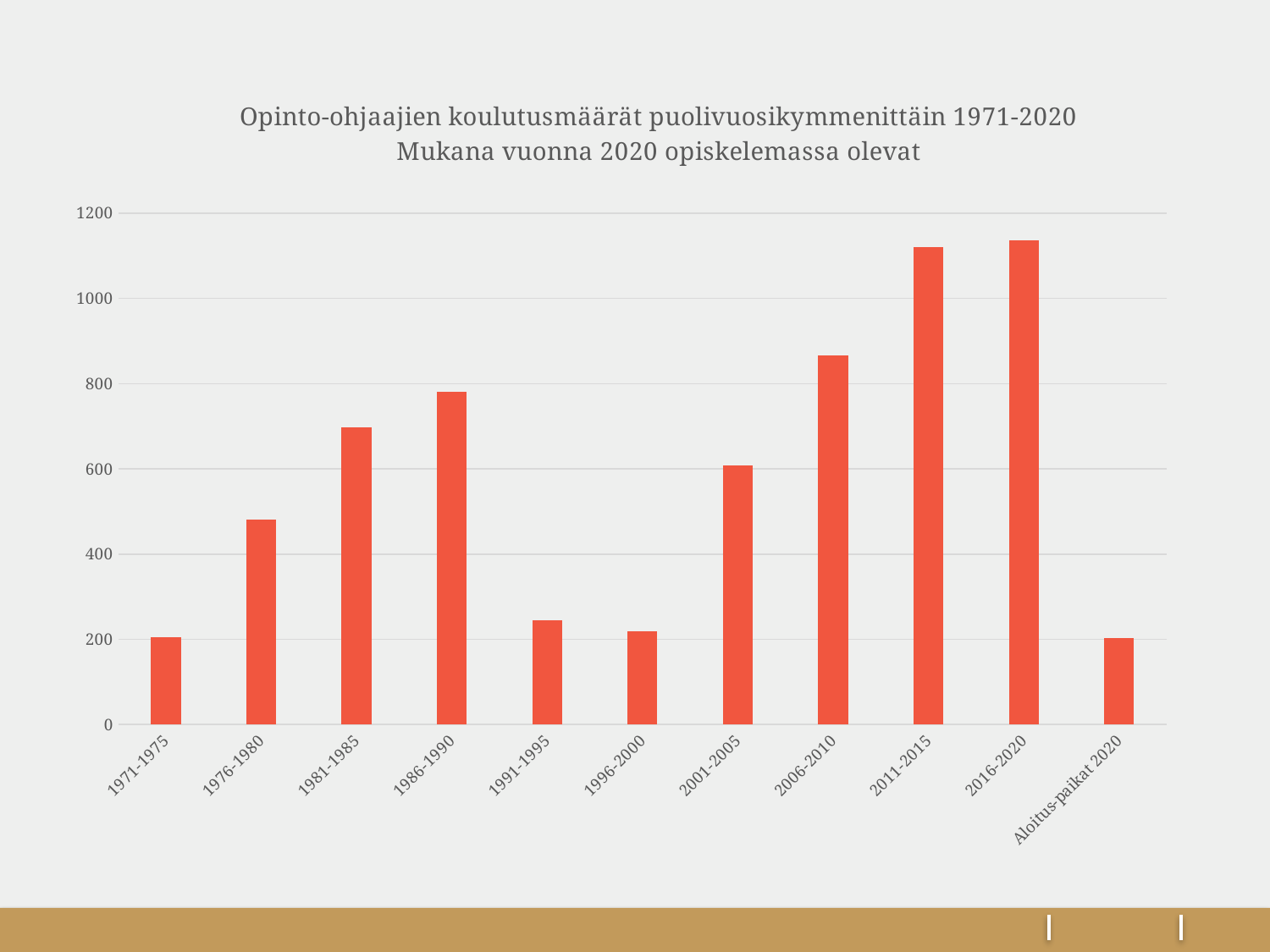
Is the value for 1991-1995 greater or less than 400? less Is the value for 2006-2010 greater or less than 800? greater Is the value for 2011-2015 greater or less than 1000? greater What is the first line of the chart's title? Opinto-ohjaajien koulutusmäärät puolivuosikymmenittäin 1971-2020 What kind of chart is shown on the slide? bar chart Which has the larger value, 2001-2005 or 2006-2010? 2006-2010 Which has the larger value, 1986-1990 or 1991-1995? 1986-1990 Which has the larger value, 1981-1985 or 1976-1980? 1981-1985 How many categories are shown on the x axis of the chart? 11 Do the values rise or fall from 2001-2005 to 2016-2020? rise